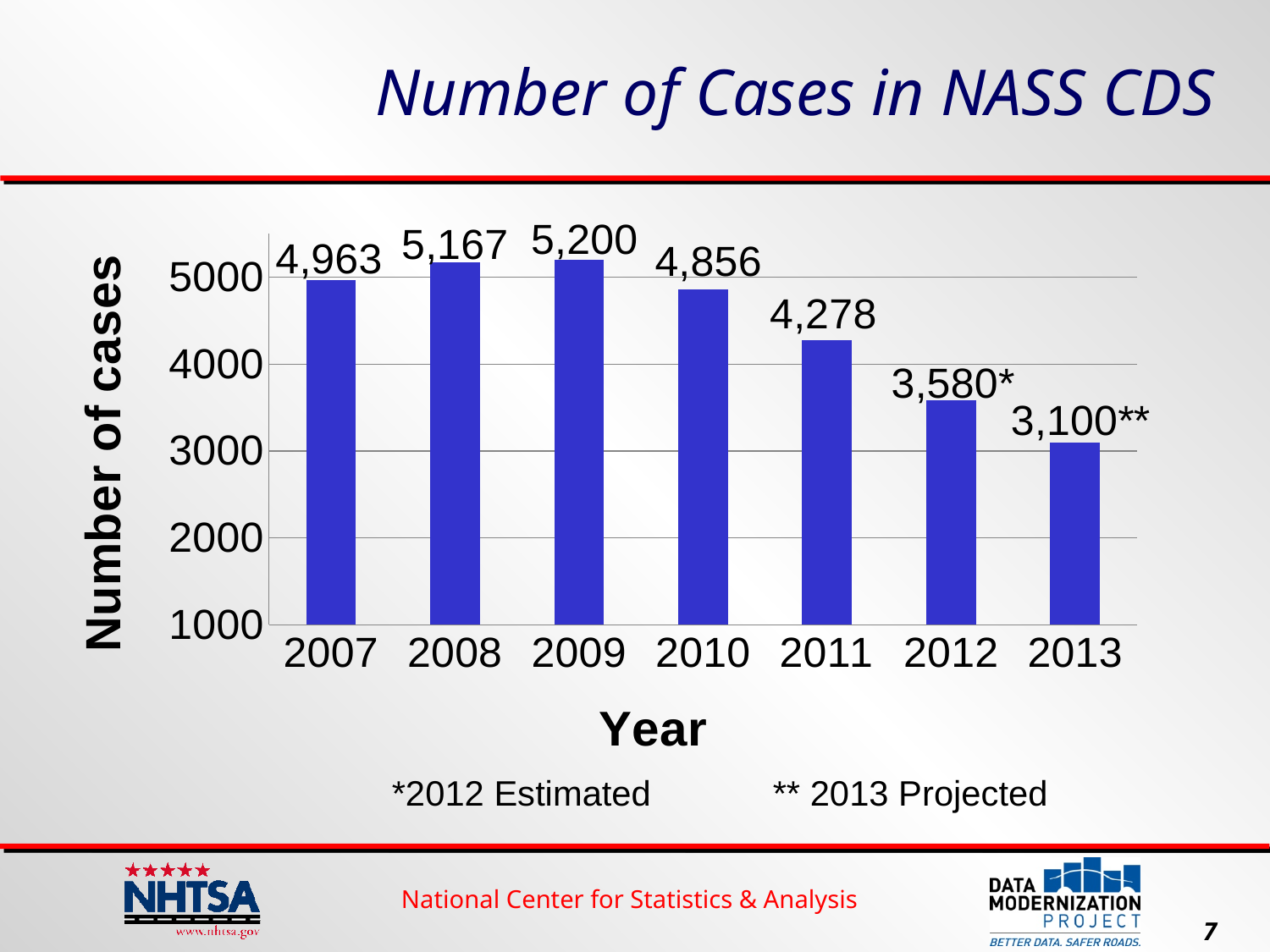
What is the estimated number of cases for 2012? 3,580 What is the number of cases in NASS CDS for 2009? 5,200 Which year has the lowest number of cases? 2013 How many years are shown on the x axis? 7 What is the difference in the number of cases between 2011 and 2013? 1,178 Do the number of cases generally rise or fall from 2009 to 2013? Fall What is the number of cases in NASS CDS for 2011? 4,278 What is the title of the chart? Number of Cases in NASS CDS Which year has more cases, 2007 or 2010? 2007 What is the difference in the number of cases between 2008 and 2010? 311 What kind of chart is shown on the slide? Bar chart Which year has the highest number of cases? 2009